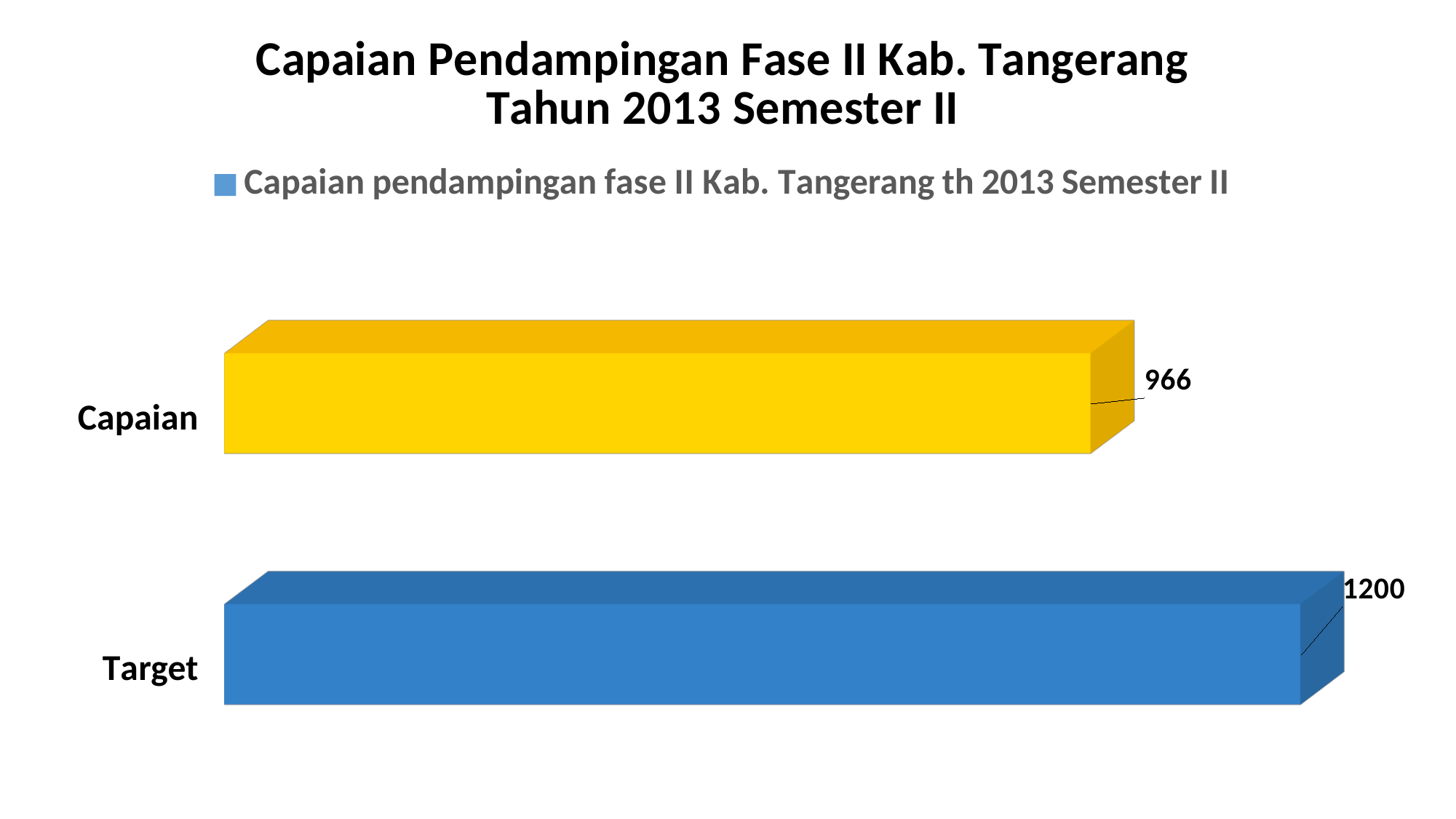
Which is larger, the value for Capaian or the value for Target? Target How many series does the legend list? 1 What is the value for Capaian? 966 How many categories are shown in the chart? 2 What colour is the Capaian bar? Yellow What is the title of the chart? Capaian Pendampingan Fase II Kab. Tangerang Tahun 2013 Semester II What is the difference between the Target value and the Capaian value? 234 What kind of chart is shown on the slide? Bar chart What is the value for Target? 1200 Which category has the lowest value? Capaian Which category has the highest value? Target